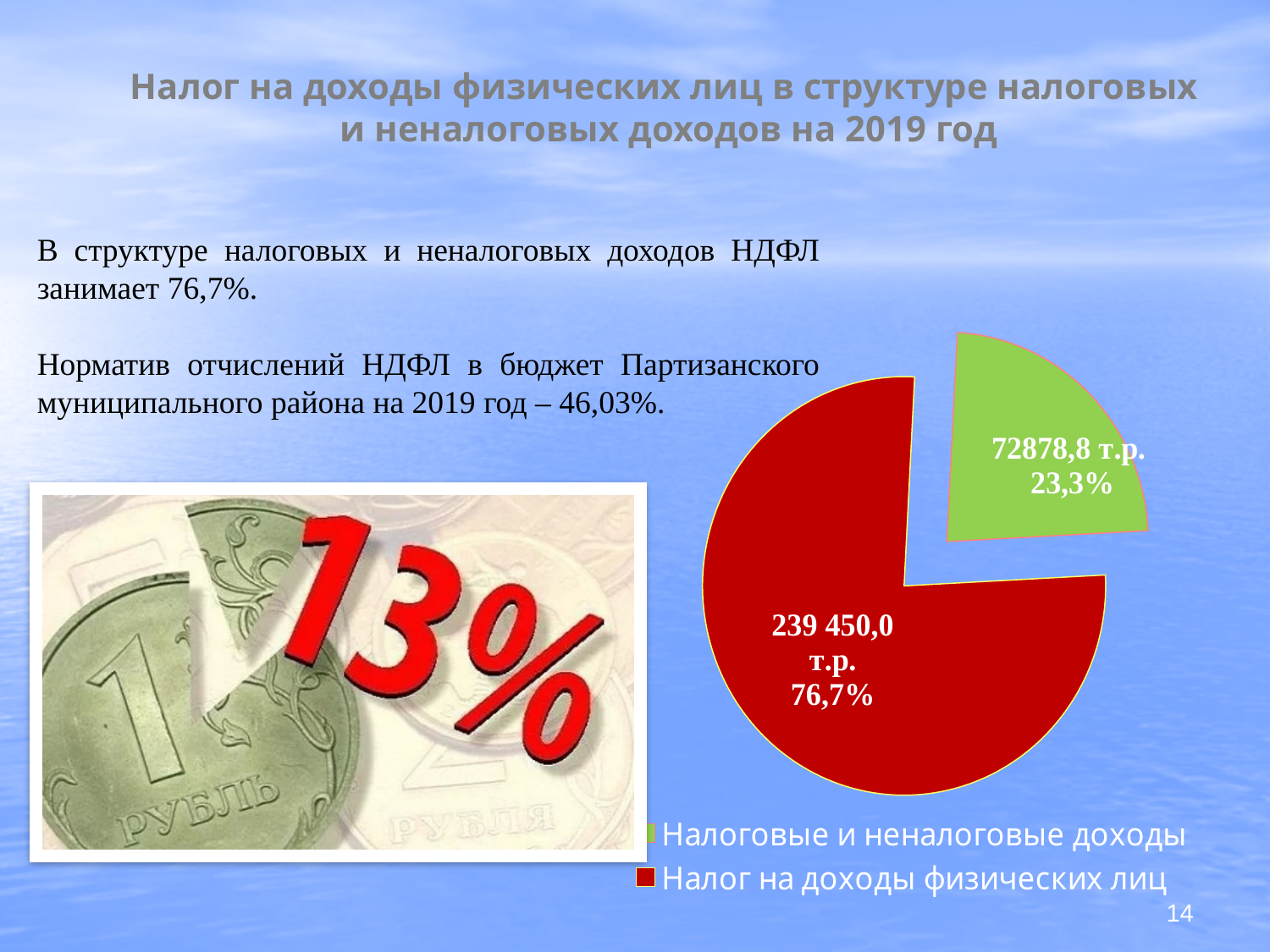
What share of the pie does the slice "Налог на доходы физических лиц" represent? 76,7% What is the difference in т.р. between the slice "Налог на доходы физических лиц" and the slice "Налоговые и неналоговые доходы"? 166 571,2 т.р. What share of the pie does the slice "Налоговые и неналоговые доходы" represent? 23,3% Which is larger: the slice "Налог на доходы физических лиц" or the slice "Налоговые и неналоговые доходы"? Налог на доходы физических лиц Which slice of the pie chart is the smallest? Налоговые и неналоговые доходы How many slices does the pie chart have? 2 Which slice of the pie chart is the largest? Налог на доходы физических лиц What value is shown for the slice "Налоговые и неналоговые доходы"? 72878,8 т.р. What colour is the slice "Налог на доходы физических лиц" in the pie chart? Red How many entries does the legend of the pie chart list? 2 What value is shown for the slice "Налог на доходы физических лиц"? 239 450,0 т.р. What kind of chart is shown on the slide? Pie chart